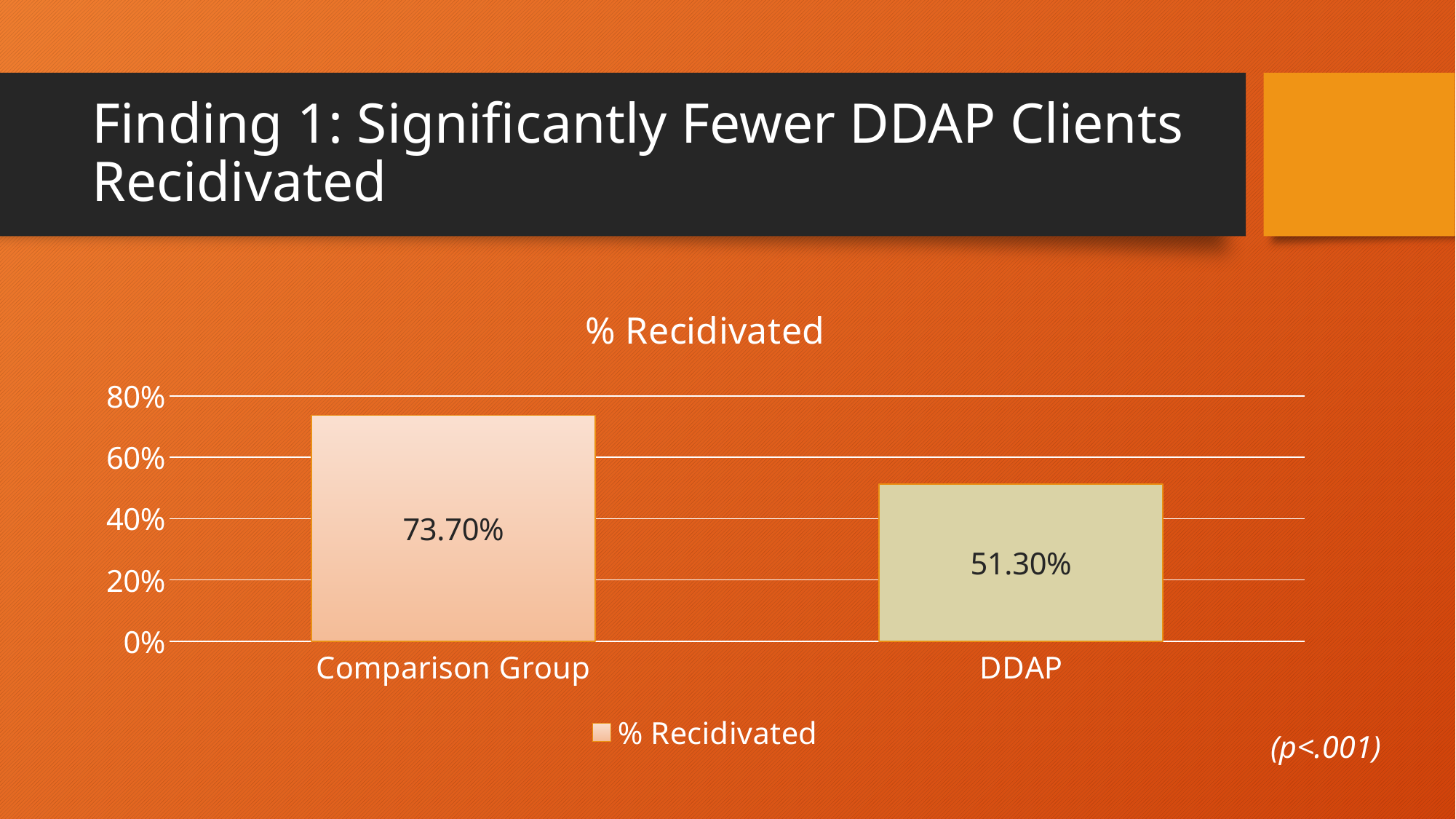
Which category has the lowest % Recidivated? DDAP What is the difference in % Recidivated between the Comparison Group and DDAP? 22.40% What is the title of the chart? % Recidivated Is the % Recidivated value for DDAP greater or less than 60%? less What is the % Recidivated value for DDAP? 51.30% How many series does the legend list? 1 Which category has the highest % Recidivated? Comparison Group What kind of chart is shown on the slide? Bar chart What is the % Recidivated value for the Comparison Group? 73.70% Which has a larger % Recidivated, the Comparison Group or DDAP? Comparison Group Is the % Recidivated value for the Comparison Group greater or less than 60%? greater How many categories are shown on the chart? 2